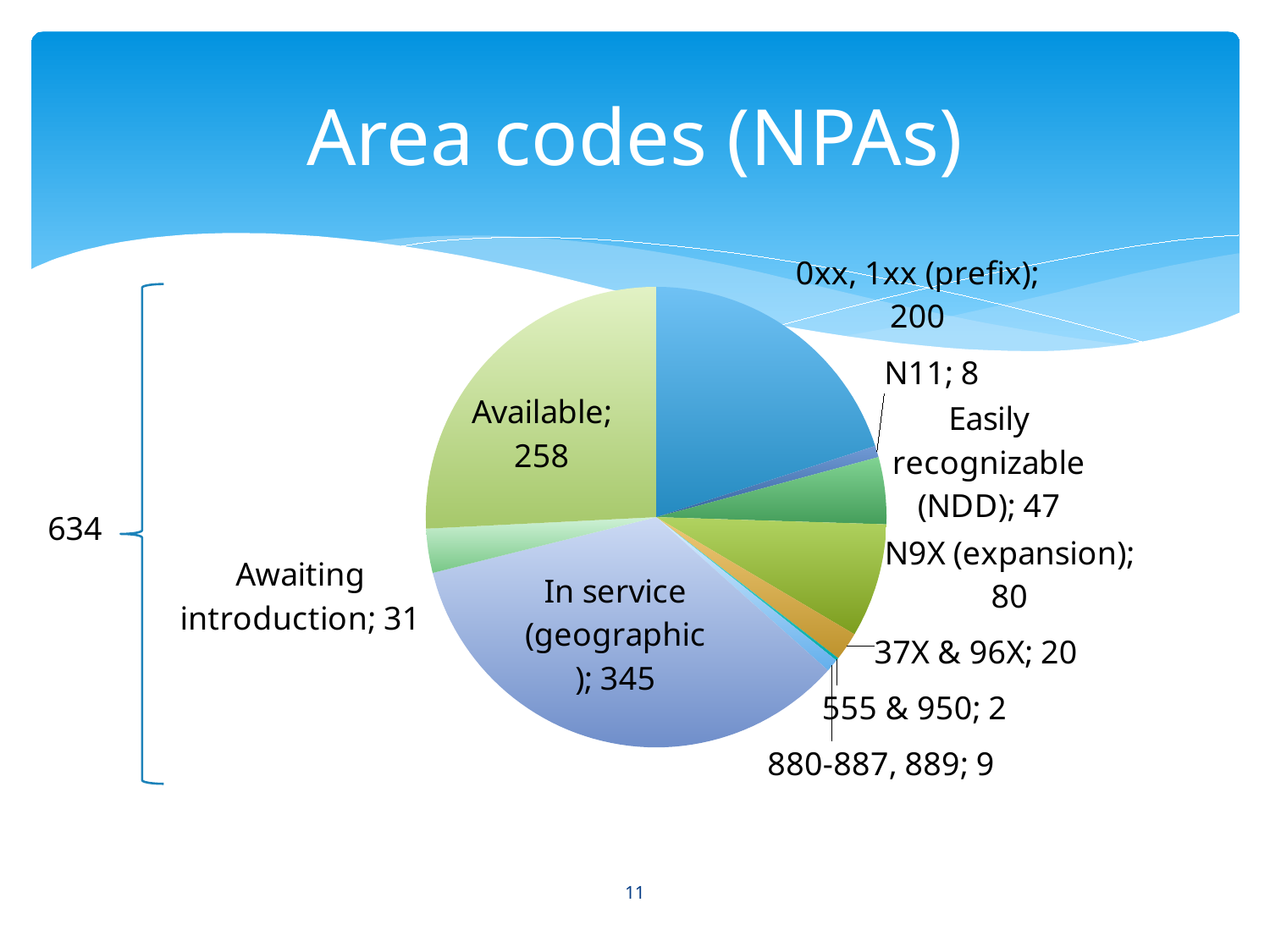
What is the value for 'N9X (expansion)'? 80 Which category has the largest slice of the pie? In service (geographic) Which category has the smallest slice of the pie? 555 & 950 What is the title of the slide containing the pie chart? Area codes (NPAs) What is the combined total of 'Awaiting introduction', 'In service (geographic)' and 'Available', as shown by the bracket on the left? 634 What kind of chart is shown on the slide? pie chart What is the value for the 'Available' slice? 258 What is the difference between the 'Available' value and the '0xx, 1xx (prefix)' value? 58 What is the value for the 'In service (geographic)' slice? 345 What is the value for '555 & 950'? 2 Which is larger, 'Easily recognizable (NDD)' or 'Awaiting introduction'? Easily recognizable (NDD) How many slices does the pie chart have? 10